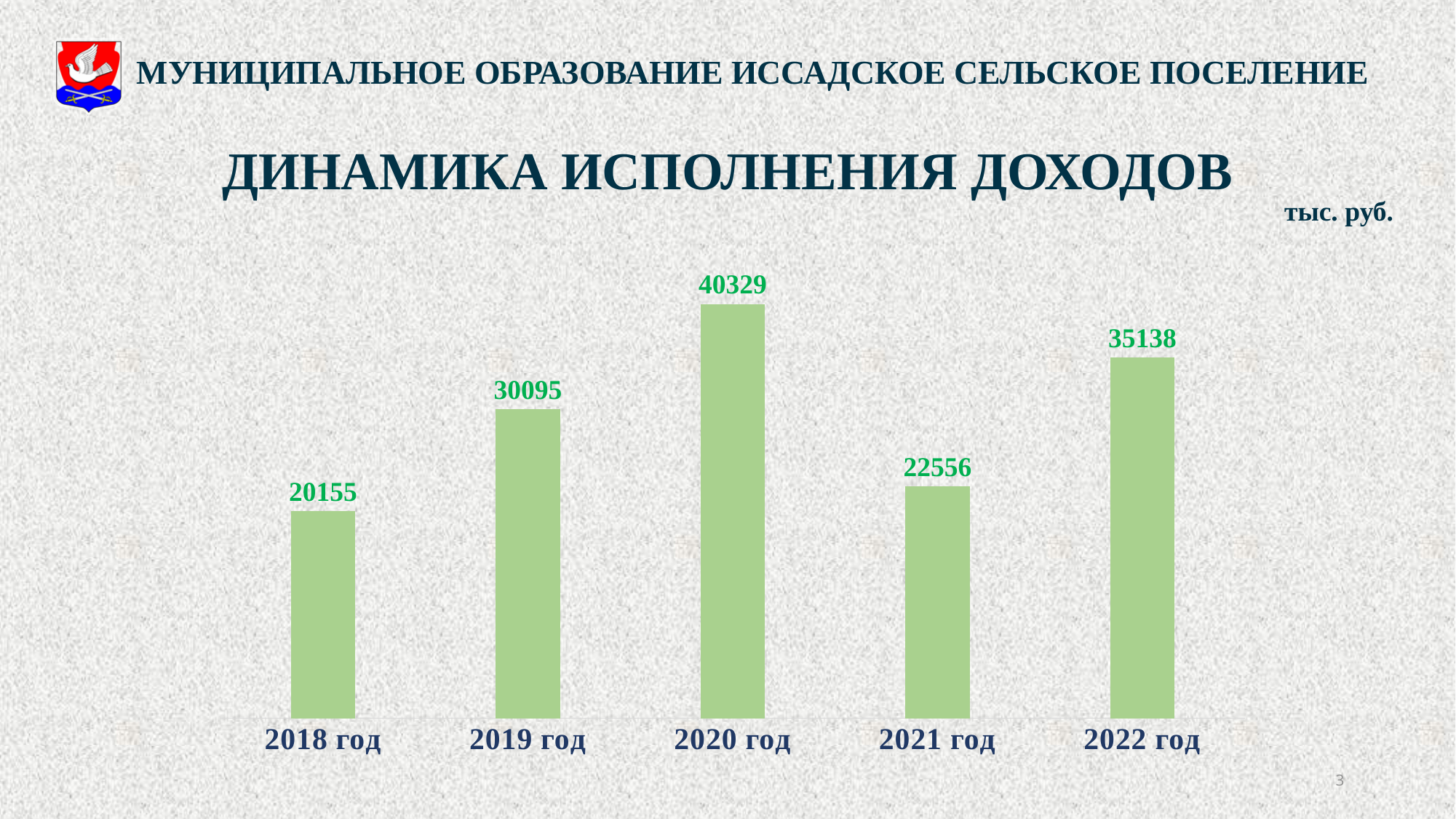
Which is larger, the value for 2019 год or the value for 2022 год? 2022 год How many years are shown on the chart? 5 What is the value for 2020 год? 40329 What is the difference between the values for 2022 год and 2018 год? 14983 Which year has the highest value? 2020 год What is the difference between the values for 2020 год and 2021 год? 17773 What is the title of the chart? ДИНАМИКА ИСПОЛНЕНИЯ ДОХОДОВ Which year has the lowest value? 2018 год What is the value for 2021 год? 22556 What is the value for 2018 год? 20155 What kind of chart is shown on the slide? bar chart What unit is indicated for the values on the chart? тыс. руб.